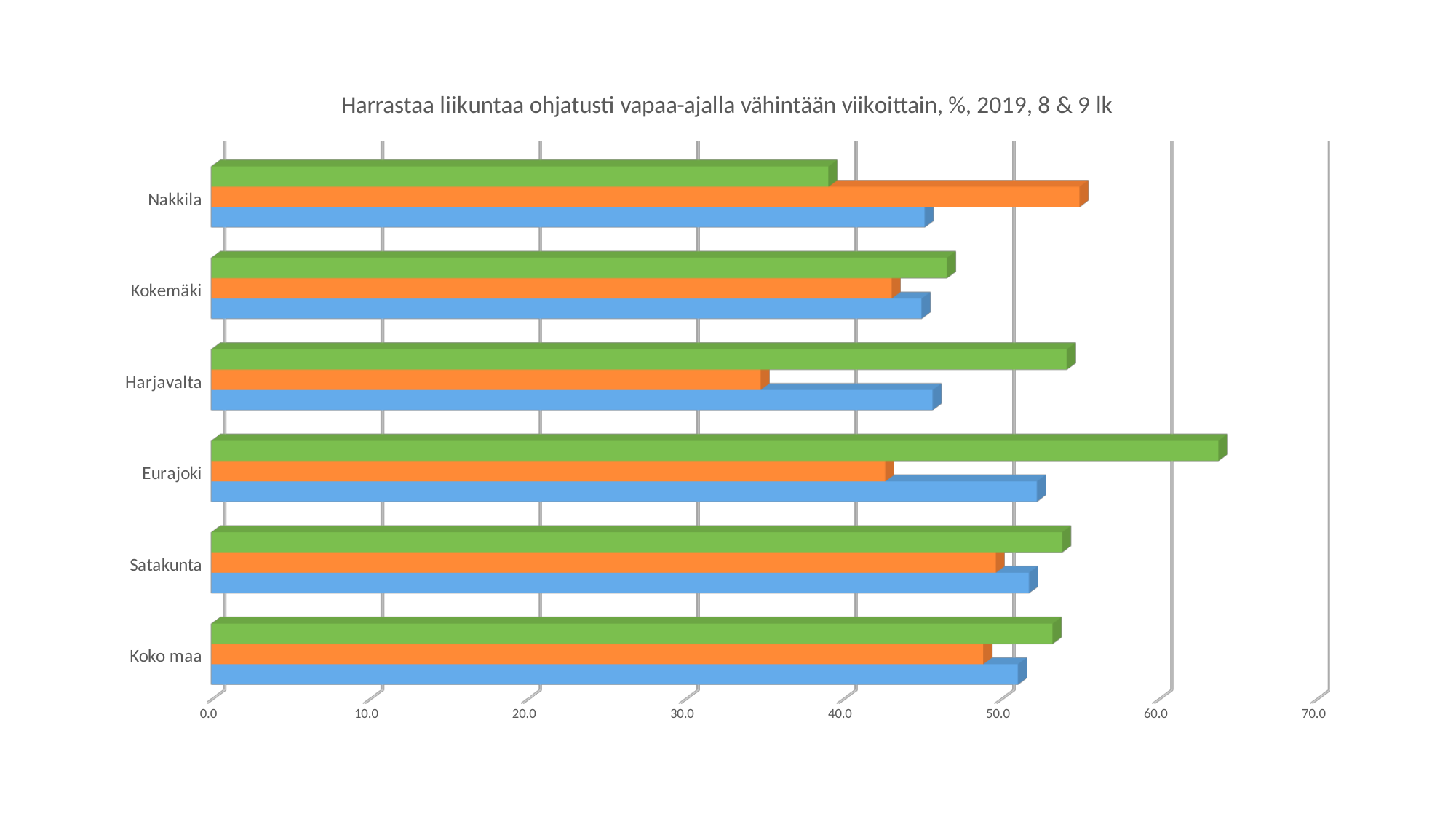
Is the value of the orange bar for Harjavalta greater or less than 40.0? less Which category has the shortest green bar? Nakkila Which category has the longest green bar? Eurajoki What is the title of the chart? Harrastaa liikuntaa ohjatusti vapaa-ajalla vähintään viikoittain, %, 2019, 8 & 9 lk How many bars are plotted for each category in the chart? 3 How many categories are shown on the vertical axis of the chart? 6 Is the value of the orange bar for Nakkila greater or less than 50.0? greater For Harjavalta, which bar is longer, the green bar or the orange bar? the green bar Which category has the shortest orange bar? Harjavalta For Nakkila, which bar is longer, the orange bar or the green bar? the orange bar What kind of chart is shown on the slide? bar chart Is the value of the green bar for Eurajoki greater or less than 60.0? greater